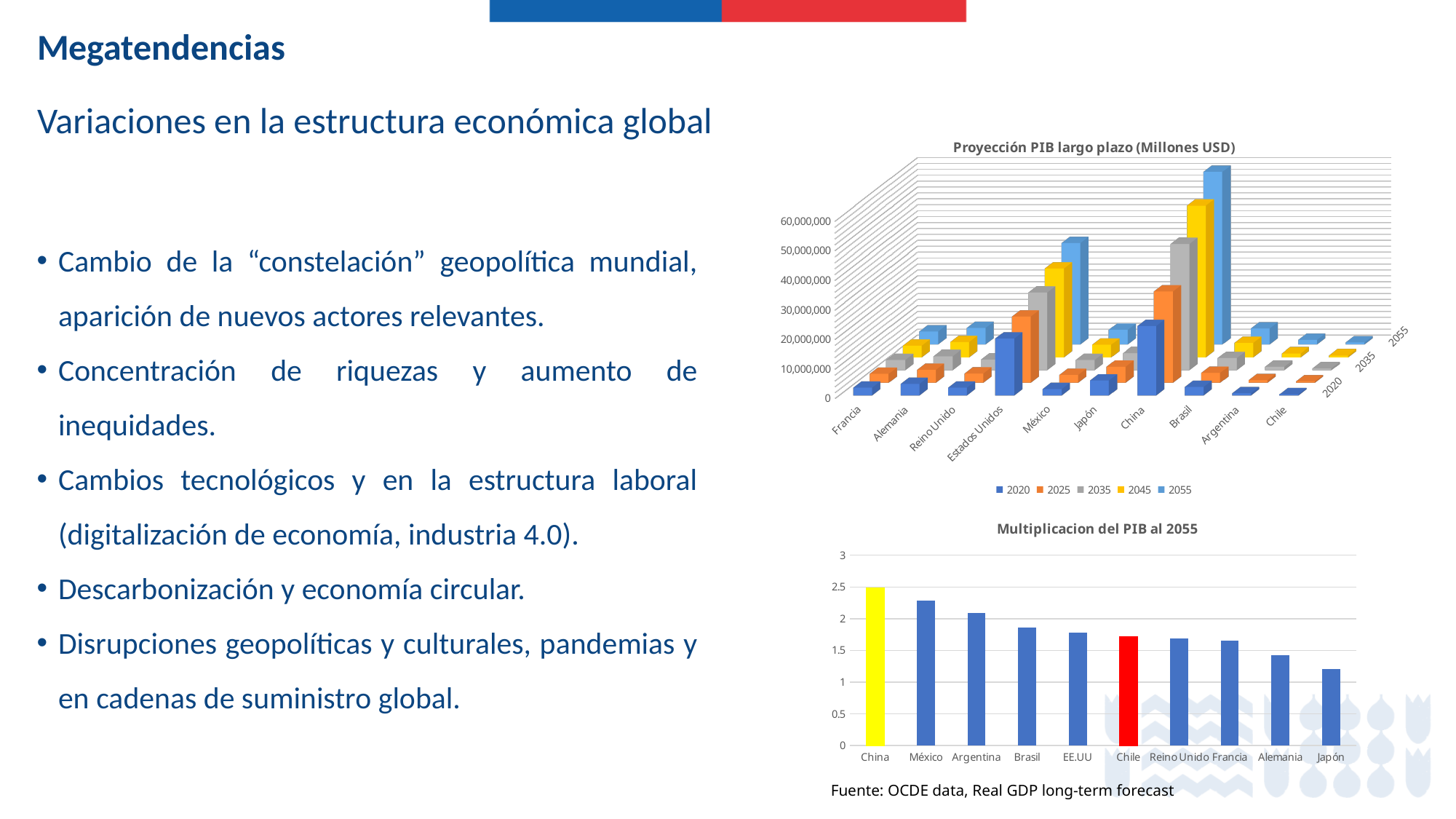
On the 'Multiplicacion del PIB al 2055' chart, which is larger, the value for México or the value for Brasil? México How many series does the legend of the 'Proyección PIB largo plazo (Millones USD)' chart list? 5 On the 'Multiplicacion del PIB al 2055' chart, which country has the highest value? China How many countries are shown on the 'Multiplicacion del PIB al 2055' chart? 10 On the 'Multiplicacion del PIB al 2055' chart, is the value for China greater or less than 2? greater On the 'Proyección PIB largo plazo (Millones USD)' chart, which country has the highest value for 2055? China On the 'Multiplicacion del PIB al 2055' chart, do the values rise or fall from left to right? fall On the 'Multiplicacion del PIB al 2055' chart, what colour is the bar for Chile? red On the 'Multiplicacion del PIB al 2055' chart, is the value for Alemania greater or less than 1.5? less What kind of chart is the 'Multiplicacion del PIB al 2055' chart? bar chart On the 'Multiplicacion del PIB al 2055' chart, is the value for Japón greater or less than 1.5? less On the 'Multiplicacion del PIB al 2055' chart, which country has the lowest value? Japón